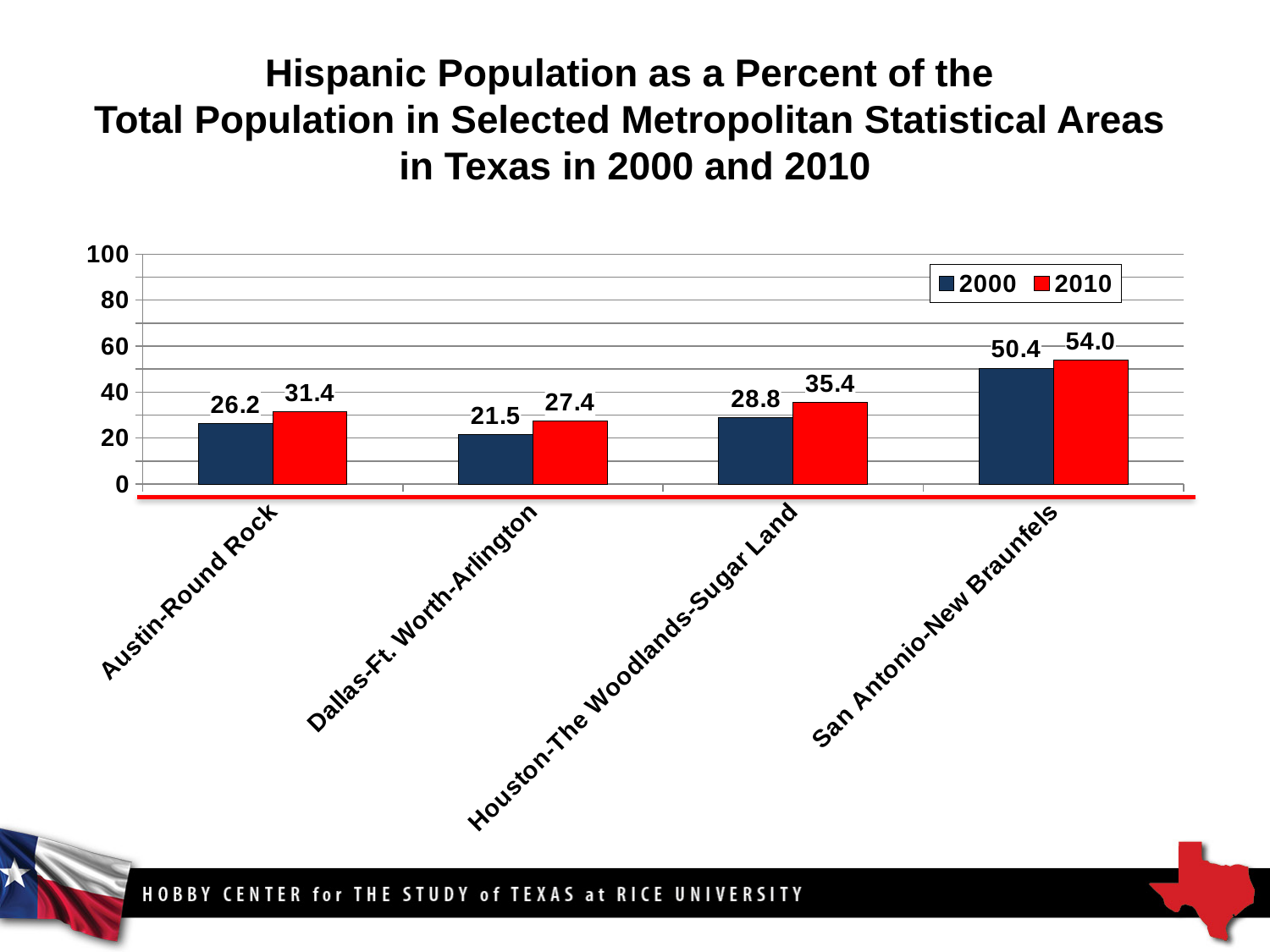
By how much did the Hispanic population percentage for San Antonio-New Braunfels increase from 2000 to 2010? 3.6 How many metropolitan statistical areas are shown on the chart? 4 Which colour represents the year 2010 in the chart? Red Which metropolitan area had the lowest Hispanic population percentage in 2000? Dallas-Ft. Worth-Arlington What is the difference between the 2010 values for Houston-The Woodlands-Sugar Land and Austin-Round Rock? 4.0 What was the Hispanic population percentage for Houston-The Woodlands-Sugar Land in 2010? 35.4 What was the Hispanic population percentage for Austin-Round Rock in 2010? 31.4 What kind of chart is shown on the slide? Bar chart What was the Hispanic population percentage for Dallas-Ft. Worth-Arlington in 2000? 21.5 Which had a higher Hispanic population percentage in 2000: Austin-Round Rock or Houston-The Woodlands-Sugar Land? Houston-The Woodlands-Sugar Land Which metropolitan area had the highest Hispanic population percentage in 2010? San Antonio-New Braunfels How many series does the legend list? 2